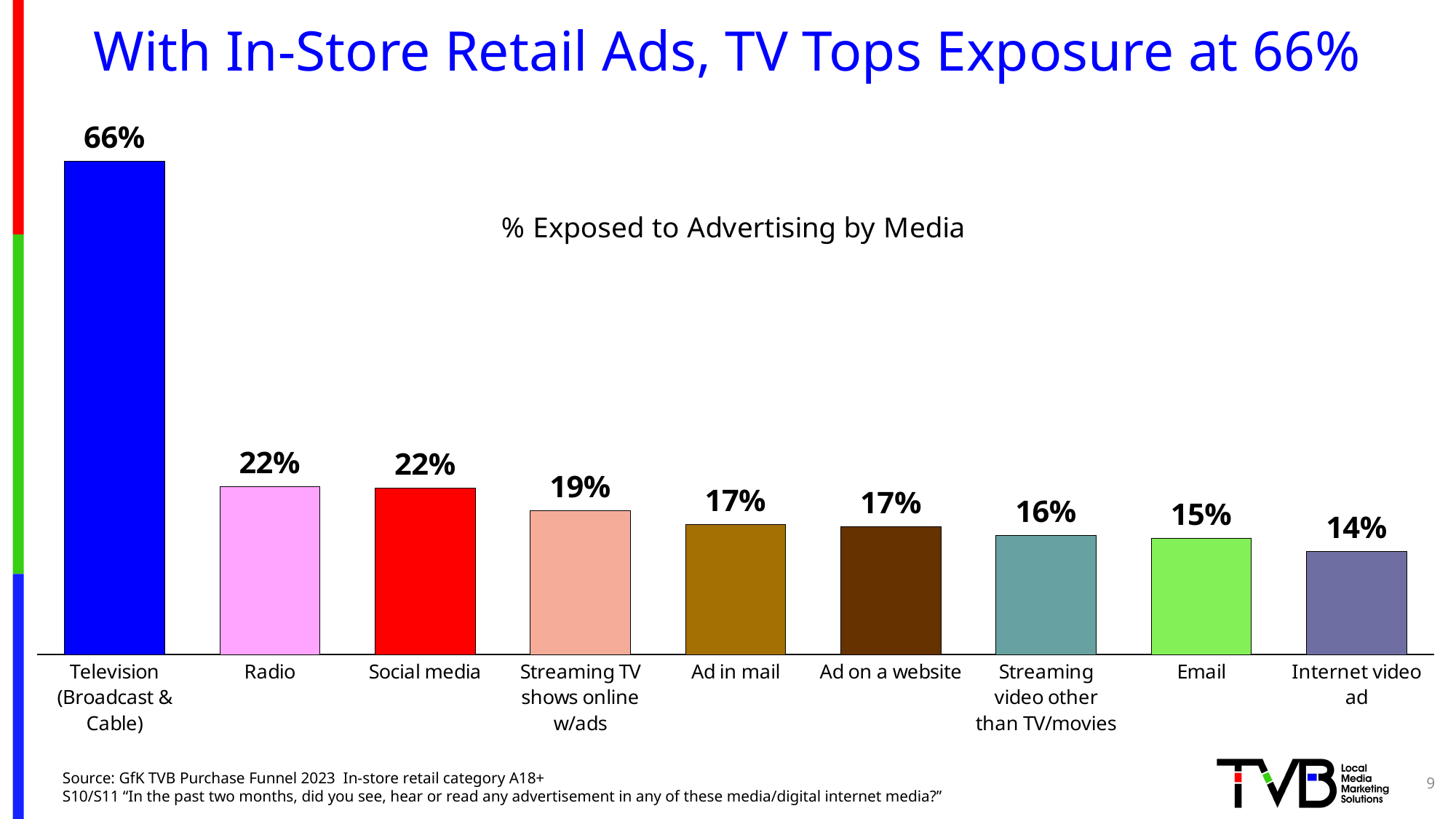
Which is larger, the value for Social media or the value for Email? Social media What kind of chart is shown on the slide? Bar chart What is the title of the chart? % Exposed to Advertising by Media How many media categories are shown in the chart? 9 What is the value for Email? 15% Which media category has the highest exposure? Television (Broadcast & Cable) What is the difference between the values for Ad in mail and Internet video ad? 3% What is the value for Streaming video other than TV/movies? 16% What is the value for Streaming TV shows online w/ads? 19% Which media category has the lowest exposure? Internet video ad What is the difference between the values for Television (Broadcast & Cable) and Radio? 44% What is the value for Television (Broadcast & Cable)? 66%